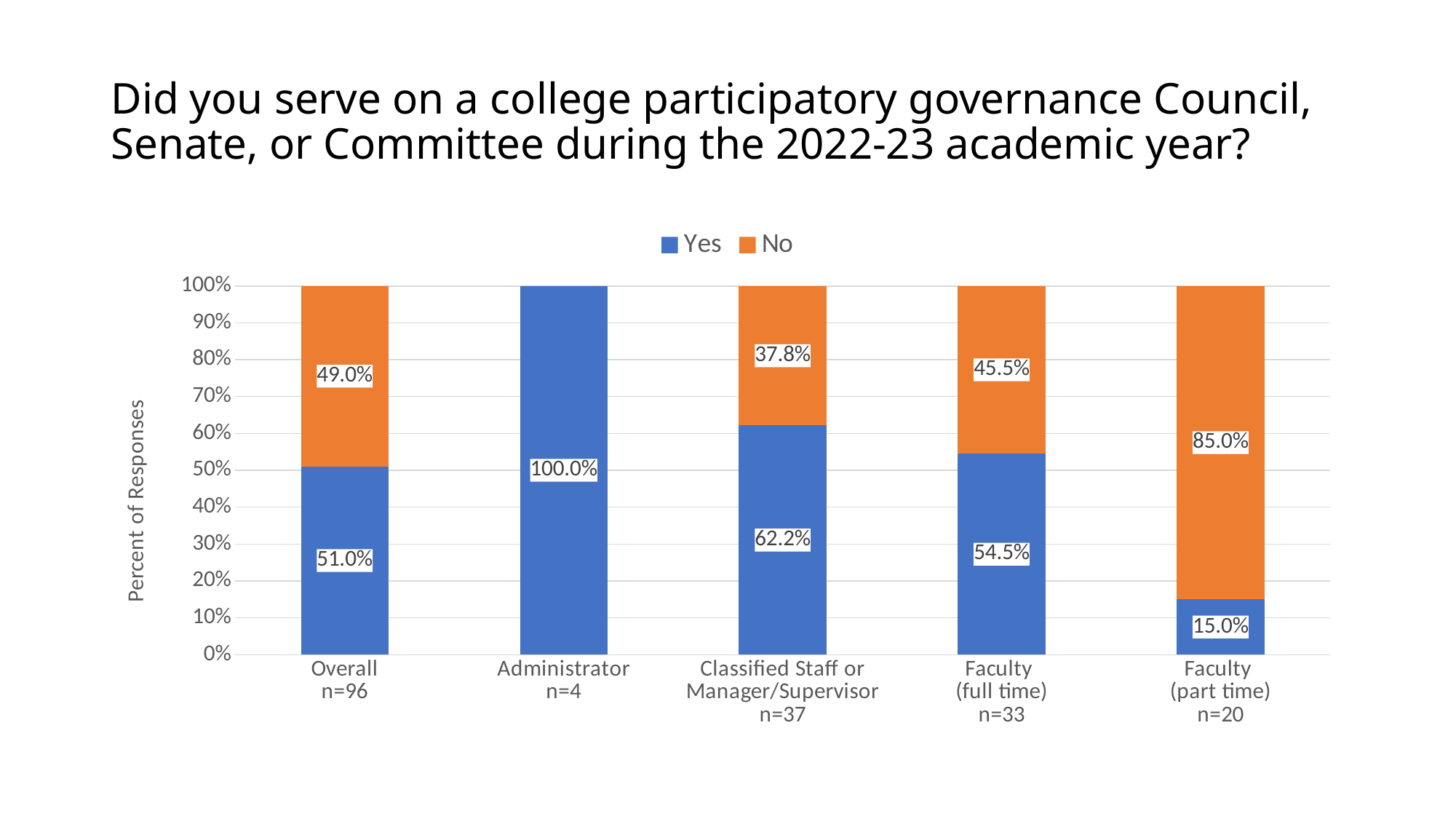
What is the sample size (n) for the Faculty (full time) group? 33 What kind of chart is shown? Stacked bar chart What percentage of Faculty (full time) respondents answered No? 45.5% Which group has the highest Yes percentage? Administrator What percentage of Faculty (part time) respondents answered No? 85.0% What percentage of Classified Staff or Manager/Supervisor respondents answered Yes? 62.2% How many groups are shown on the x axis? 5 How many series does the legend list? 2 What percentage of Overall respondents answered Yes? 51.0% Which is larger: the No percentage for Overall or the No percentage for Classified Staff or Manager/Supervisor? Overall Which group has the lowest Yes percentage? Faculty (part time) What is the difference between the Yes percentages for Classified Staff or Manager/Supervisor and Faculty (full time)? 7.7%